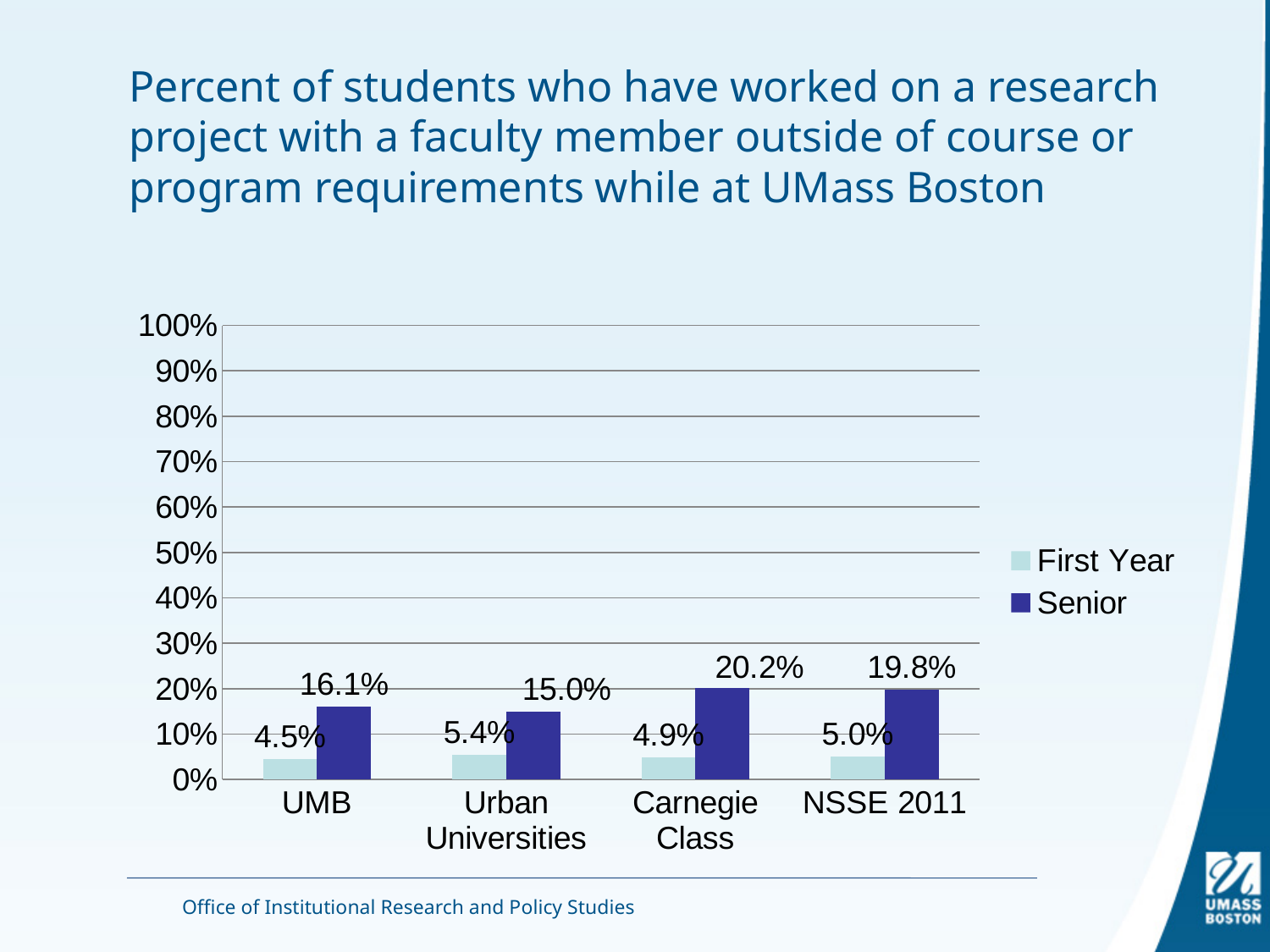
Which category has the lowest First Year value? UMB What is the First Year value for Urban Universities? 5.4% How many series does the legend list? 2 How many categories are shown on the x axis? 4 What is the difference between the Senior and First Year values for UMB? 11.6% Which category has the highest Senior value? Carnegie Class Is the Senior value for Carnegie Class greater or less than 30%? less What is the Senior value for Carnegie Class? 20.2% Which is larger, the Senior value for Urban Universities or the Senior value for NSSE 2011? NSSE 2011 What is the Senior value for UMB? 16.1% What is the First Year value for NSSE 2011? 5.0% What kind of chart is shown on the slide? bar chart